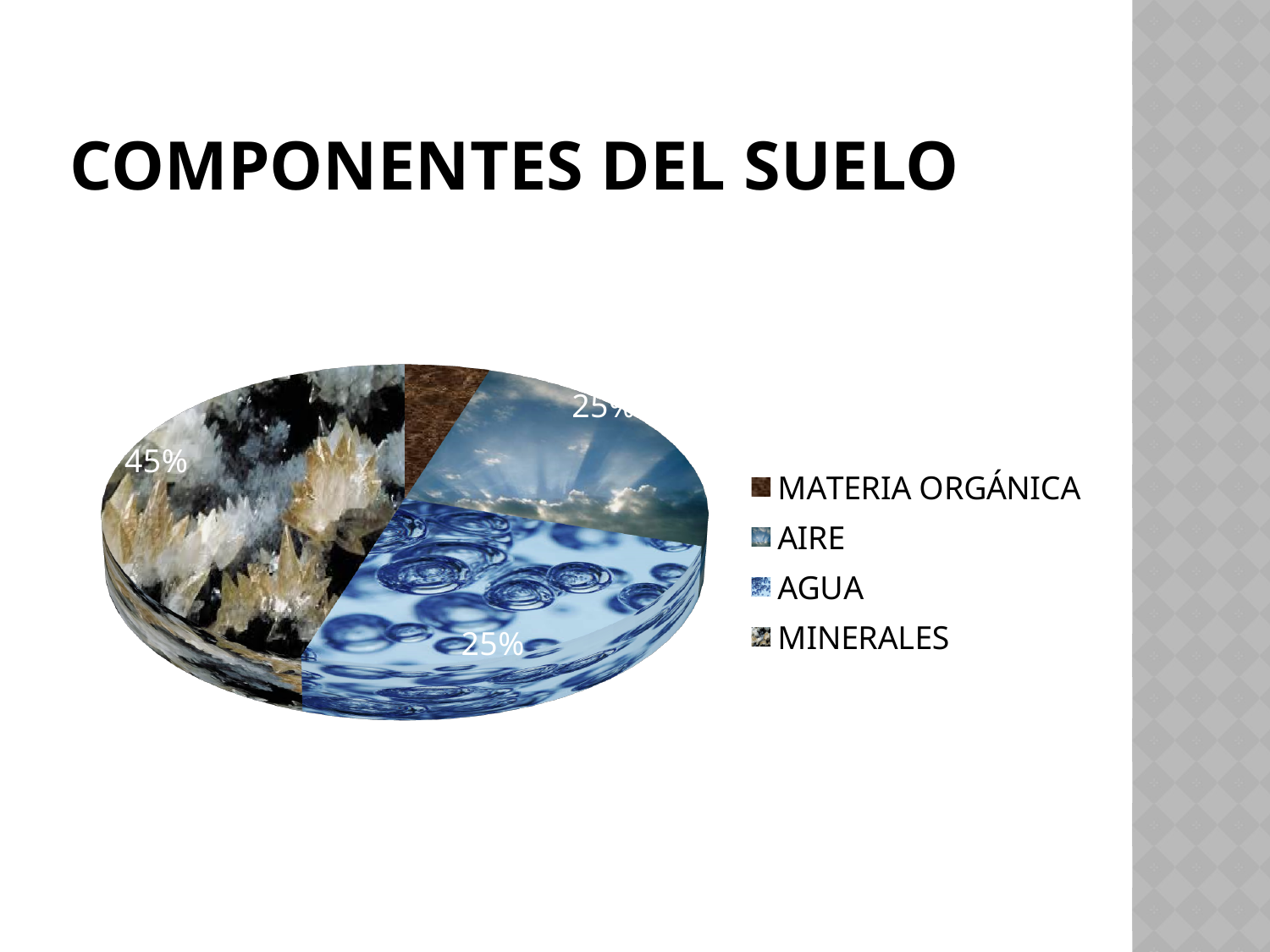
How many entries does the chart legend list? 4 By how many percentage points does MINERALES exceed AGUA? 20 What is the title of the slide containing the chart? COMPONENTES DEL SUELO Which component has the smallest slice of the pie? MATERIA ORGÁNICA What percentage is shown for AGUA? 25% What kind of chart is shown on the slide? pie chart What percentage is shown for MINERALES? 45% Which component has the largest slice of the pie? MINERALES What share of the pie does AGUA represent? 25% How many categories does the pie chart show? 4 What percentage is shown for AIRE? 25% Which is larger, the slice for MINERALES or the slice for AGUA? MINERALES